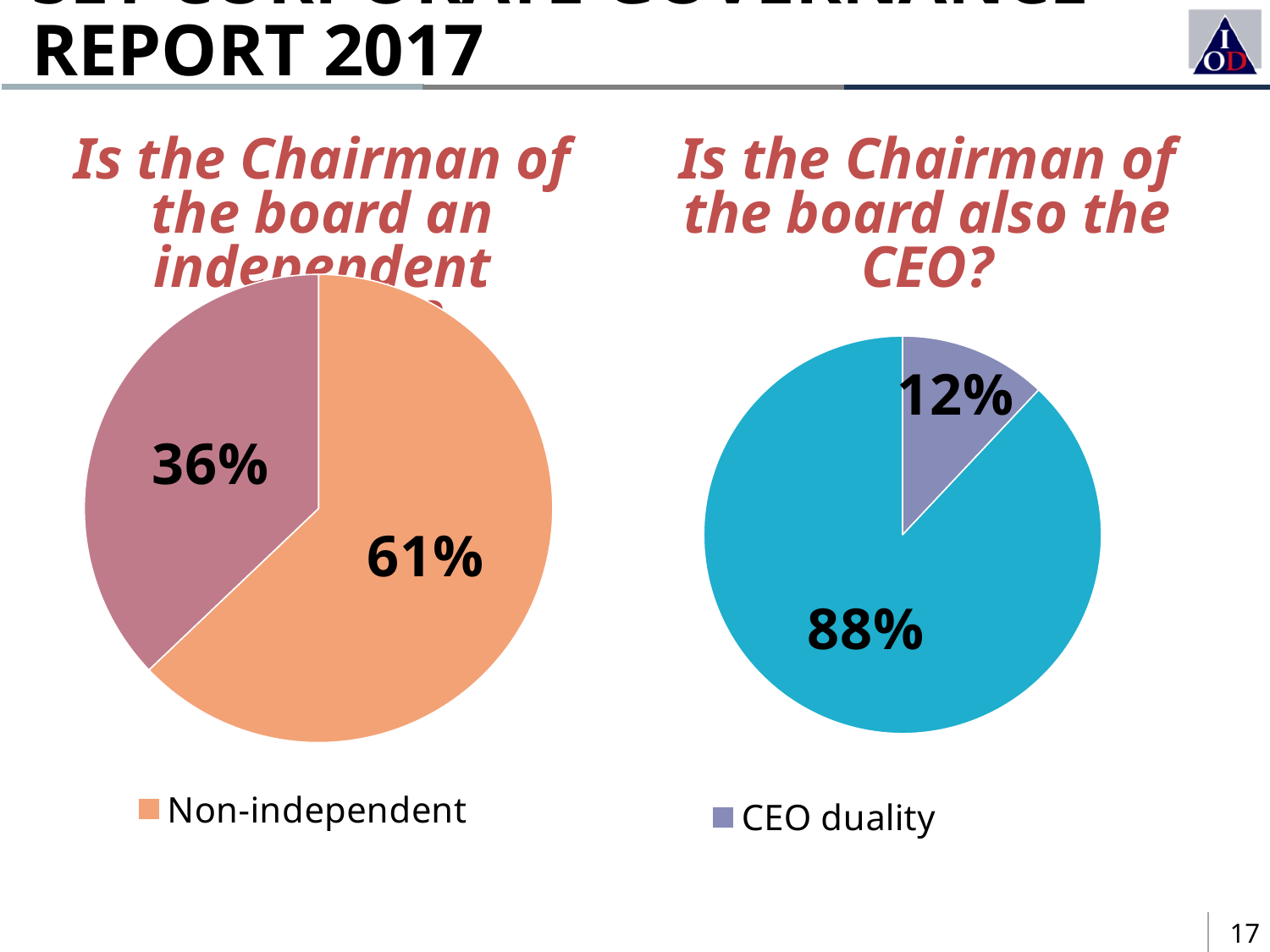
On the right pie chart, which slice is larger: the CEO duality slice or the other slice? the other slice (88%) On the right pie chart, what is the difference between the 88% slice and the 12% slice? 76% On the left pie chart, what share is shown for Non-independent? 61% On the right pie chart, what share is shown for CEO duality? 12% How many slices does the left pie chart have? 2 On the left pie chart, what is the difference between the two slices, 61% and 36%? 25% On the left pie chart, what is the value of the smaller slice? 36% What type of chart is used on the right side of the slide, titled 'Is the Chairman of the board also the CEO?'? pie chart On the right pie chart, what is the value of the larger slice? 88% What legend entry is shown below the right pie chart? CEO duality What legend entry is shown below the left pie chart? Non-independent How many slices does the right pie chart have? 2